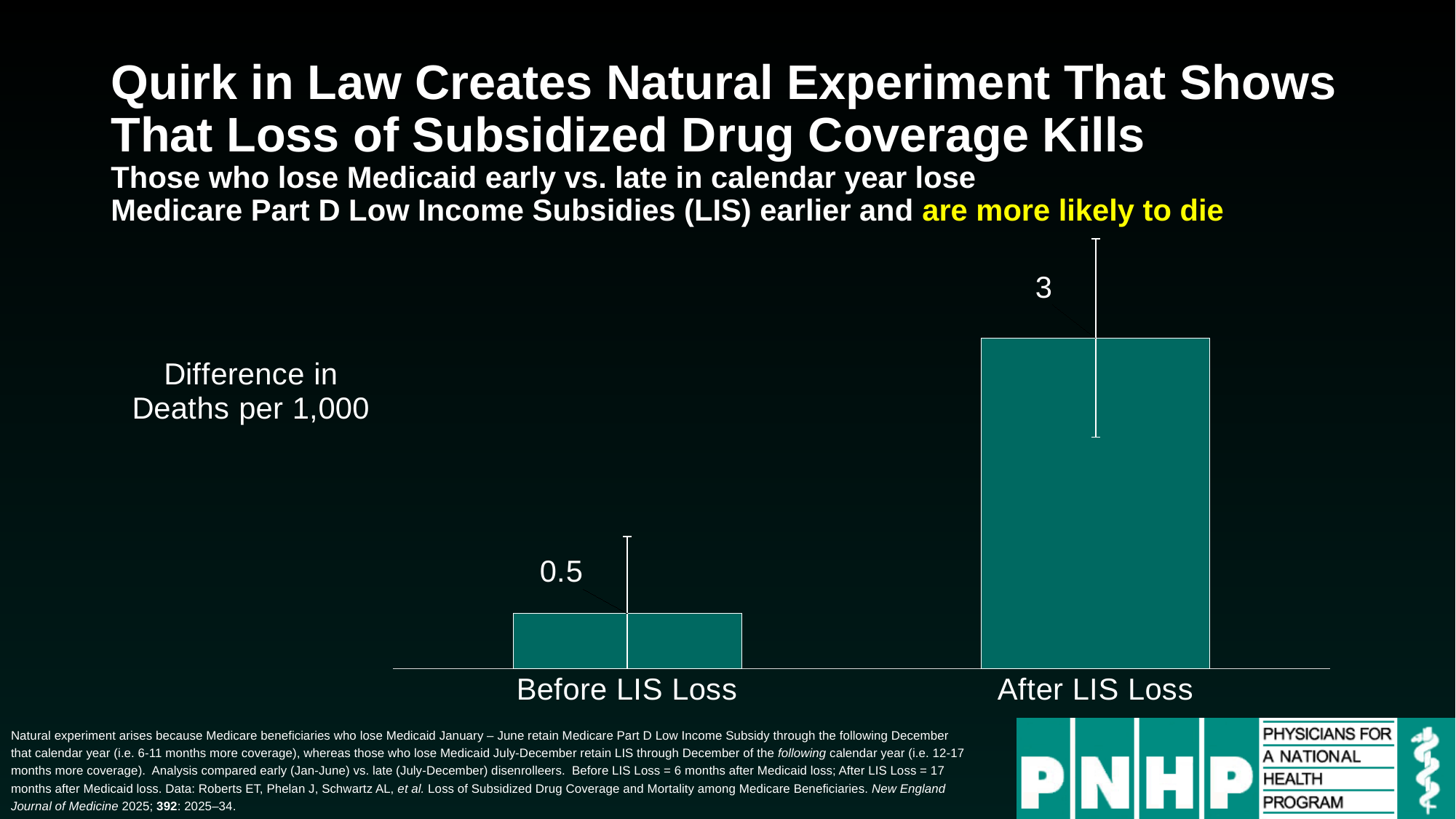
How much larger is the value for After LIS Loss than for Before LIS Loss? 2.5 Which category has the higher value, Before LIS Loss or After LIS Loss? After LIS Loss Do the values rise or fall from Before LIS Loss to After LIS Loss? rise What colour are the bars in the chart? teal What quantity does the chart's axis label say is plotted? Difference in Deaths per 1,000 How many categories are shown on the chart? 2 What is the difference in deaths per 1,000 for After LIS Loss? 3 Is the value for Before LIS Loss larger or smaller than the value for After LIS Loss? smaller What is the difference in deaths per 1,000 for Before LIS Loss? 0.5 Which category has the lowest value? Before LIS Loss What kind of chart is shown on the slide? bar chart